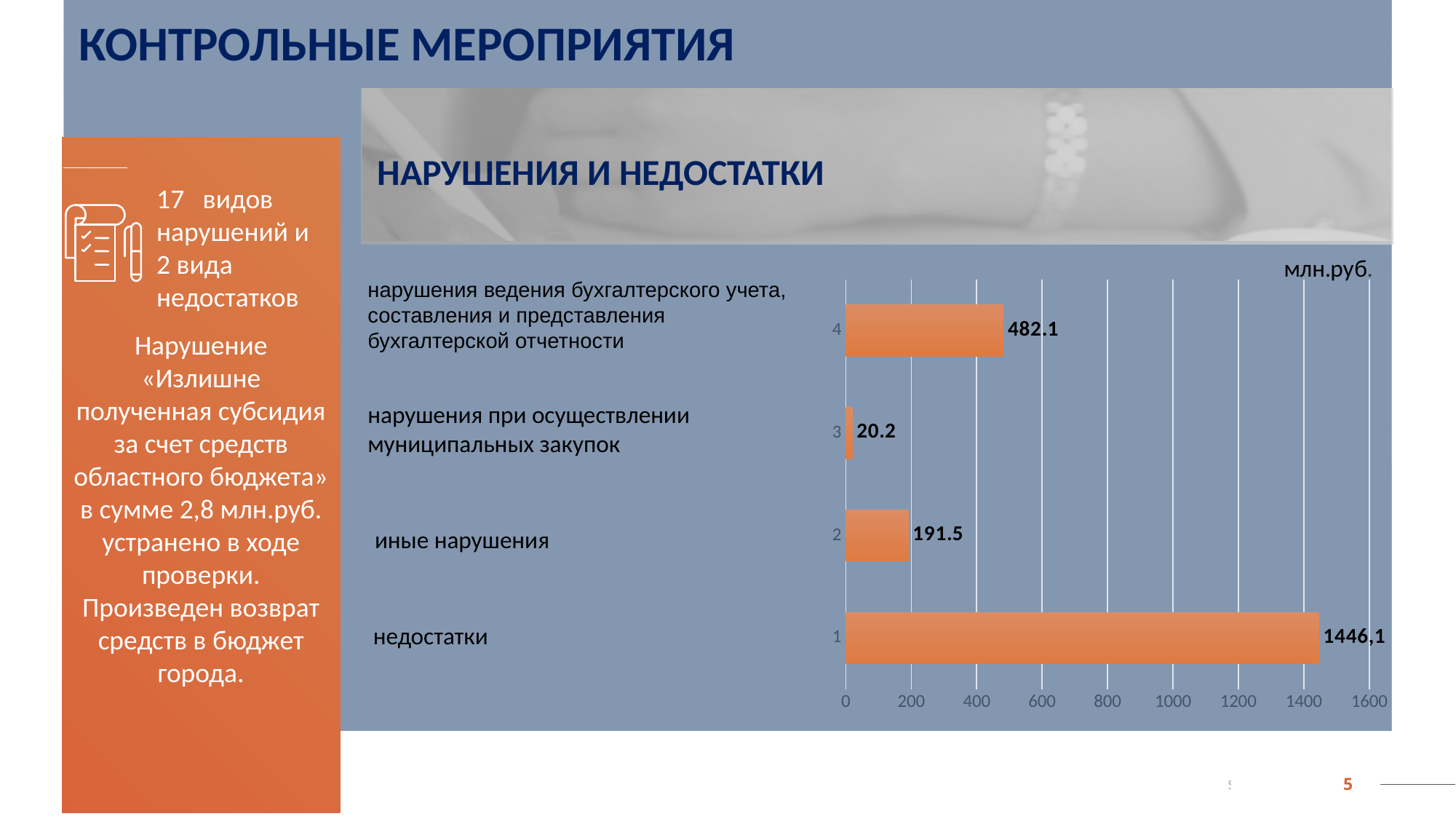
Which category has the lowest value in the chart? нарушения при осуществлении муниципальных закупок What is the value for "недостатки" in the chart? 1446,1 How many bars are shown in the chart? 4 Which is larger: the value for "иные нарушения" or the value for "нарушения при осуществлении муниципальных закупок"? иные нарушения What is the difference between the values for "нарушения ведения бухгалтерского учета, составления и представления бухгалтерской отчетности" and "иные нарушения"? 290.6 Which category has the highest value in the chart? недостатки What is the value for "нарушения при осуществлении муниципальных закупок" in the chart? 20.2 What type of chart is shown on the slide? bar chart What unit of measurement is indicated above the chart? млн.руб. What is the value for "нарушения ведения бухгалтерского учета, составления и представления бухгалтерской отчетности" in the chart? 482.1 What is the value for "иные нарушения" in the chart? 191.5 What is the difference between the values for "иные нарушения" and "нарушения при осуществлении муниципальных закупок"? 171.3